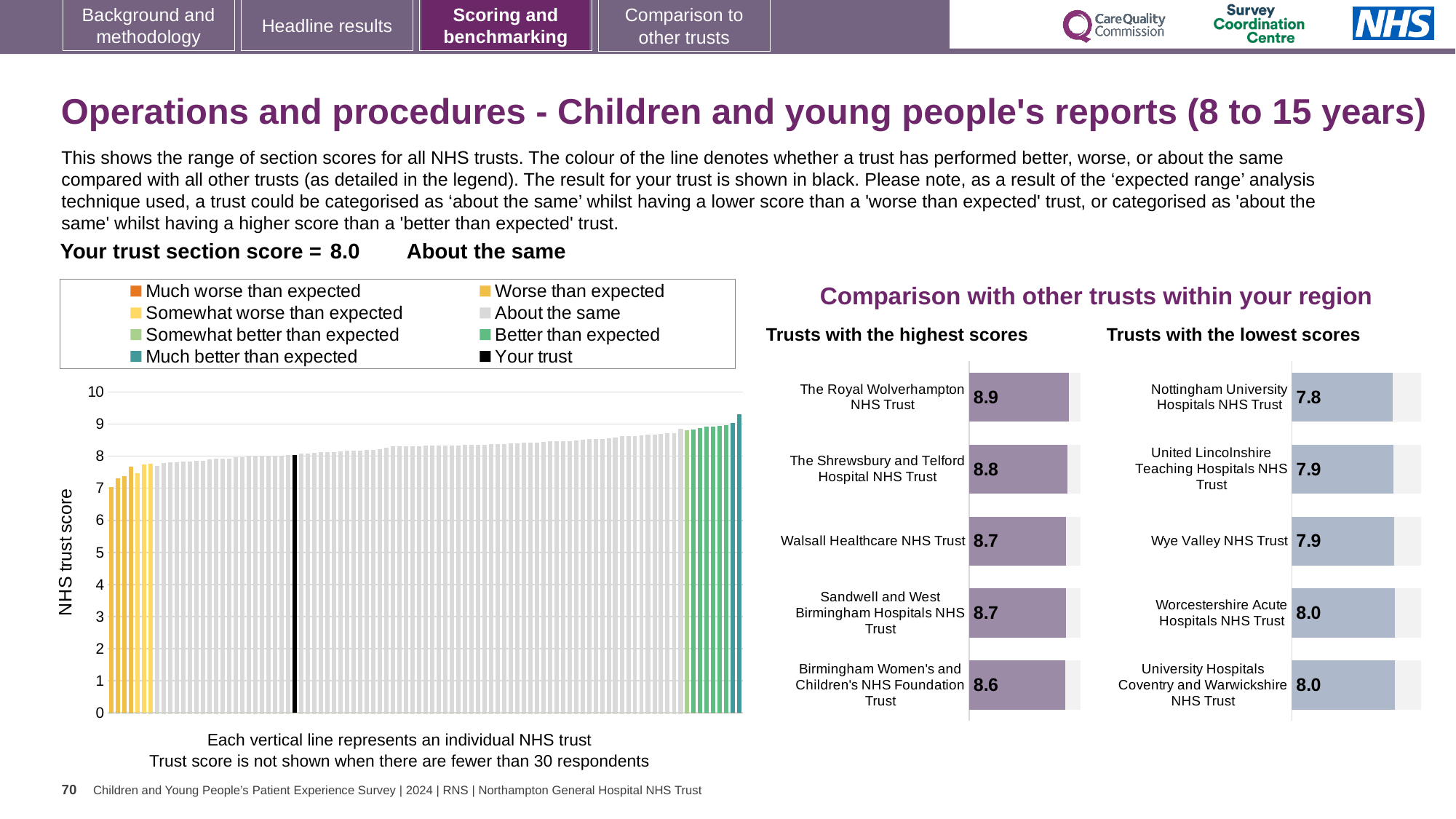
In the 'Trusts with the highest scores' chart, which trust has the highest score? The Royal Wolverhampton NHS Trust How many trusts are shown in the 'Trusts with the highest scores' chart? 5 In the 'Trusts with the highest scores' chart, what is the score for The Royal Wolverhampton NHS Trust? 8.9 In the 'Trusts with the lowest scores' chart, what is the score for Wye Valley NHS Trust? 7.9 What is the label on the vertical axis of the main chart on the left? NHS trust score How many entries does the legend of the main NHS trust score chart list? 8 In the main NHS trust score chart, do the bar values rise or fall from left to right? Rise In the 'Trusts with the highest scores' chart, what is the difference between the scores of The Royal Wolverhampton NHS Trust and Birmingham Women's and Children's NHS Foundation Trust? 0.3 What kind of chart is the main chart on the left showing NHS trust scores? Bar chart In the 'Trusts with the lowest scores' chart, what is the score for Nottingham University Hospitals NHS Trust? 7.8 In the 'Trusts with the highest scores' chart, which has the larger score: The Shrewsbury and Telford Hospital NHS Trust or Walsall Healthcare NHS Trust? The Shrewsbury and Telford Hospital NHS Trust In the 'Trusts with the lowest scores' chart, which trust has the lowest score? Nottingham University Hospitals NHS Trust